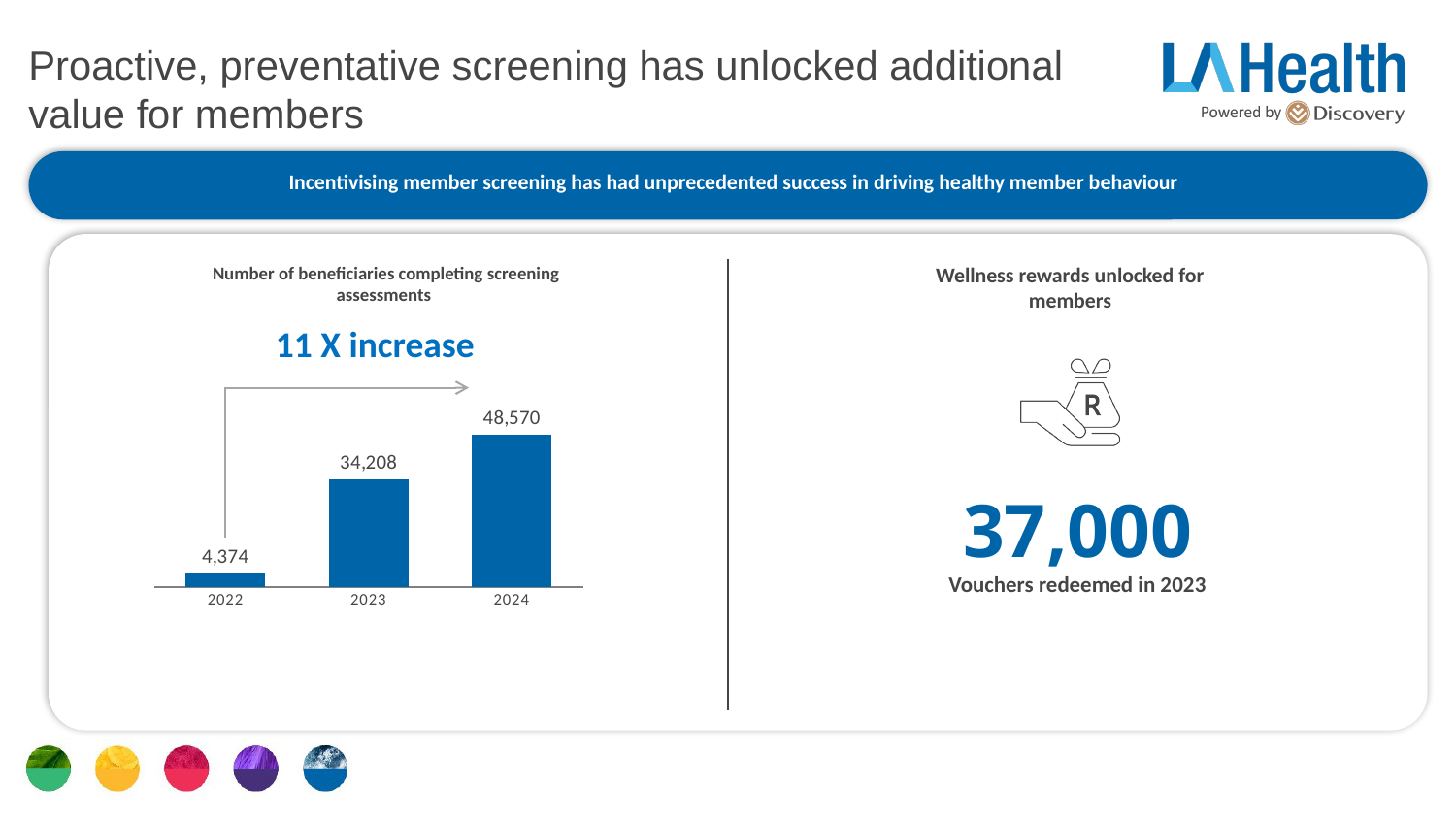
What increase factor is annotated above the chart of beneficiaries completing screening assessments? 11 X increase Which year has more beneficiaries completing screening assessments, 2022 or 2023? 2023 What is the difference between the number of beneficiaries completing screening assessments in 2024 and 2023? 14,362 What is the number of beneficiaries completing screening assessments in 2024? 48,570 What kind of chart shows the number of beneficiaries completing screening assessments? Bar chart What is the number of beneficiaries completing screening assessments in 2023? 34,208 Which year has the highest number of beneficiaries completing screening assessments? 2024 What is the difference between the number of beneficiaries completing screening assessments in 2023 and 2022? 29,834 Which year has the lowest number of beneficiaries completing screening assessments? 2022 What is the number of beneficiaries completing screening assessments in 2022? 4,374 How many years are shown in the chart of beneficiaries completing screening assessments? 3 Do the number of beneficiaries completing screening assessments rise or fall from 2022 to 2024? Rise